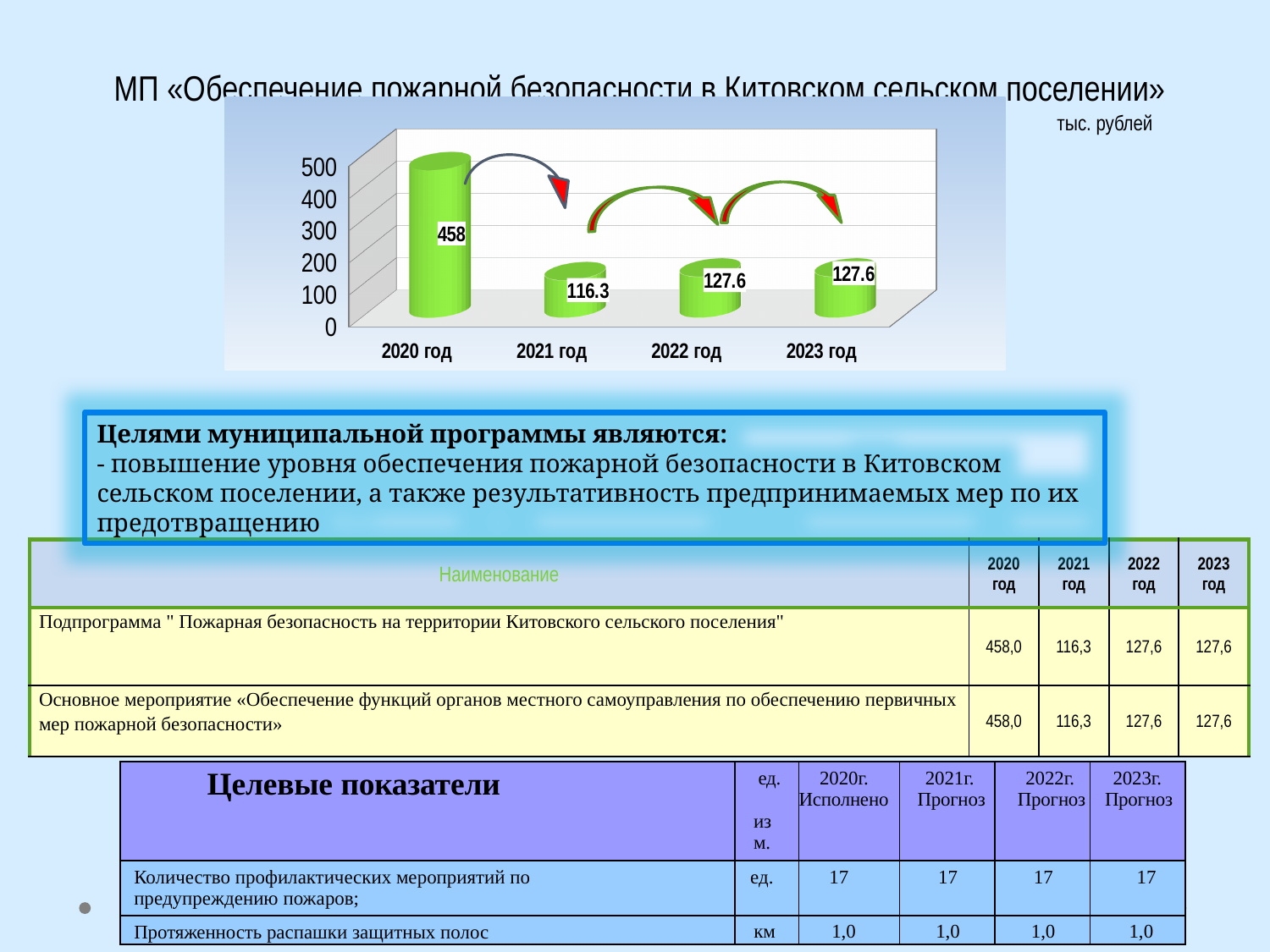
Which year has the lowest value? 2021 год Is the value for 2020 год greater or less than 400? greater What is the value shown for 2021 год? 116.3 What kind of chart is shown on the slide? bar chart What unit is indicated for the chart values? тыс. рублей What is the value shown for 2022 год? 127.6 Which year has the highest value? 2020 год What is the difference between the values for 2020 год and 2021 год? 341.7 What is the difference between the values for 2022 год and 2021 год? 11.3 How many years are shown on the x axis of the chart? 4 Which is larger, the value for 2021 год or the value for 2023 год? 2023 год What is the value shown for 2020 год? 458